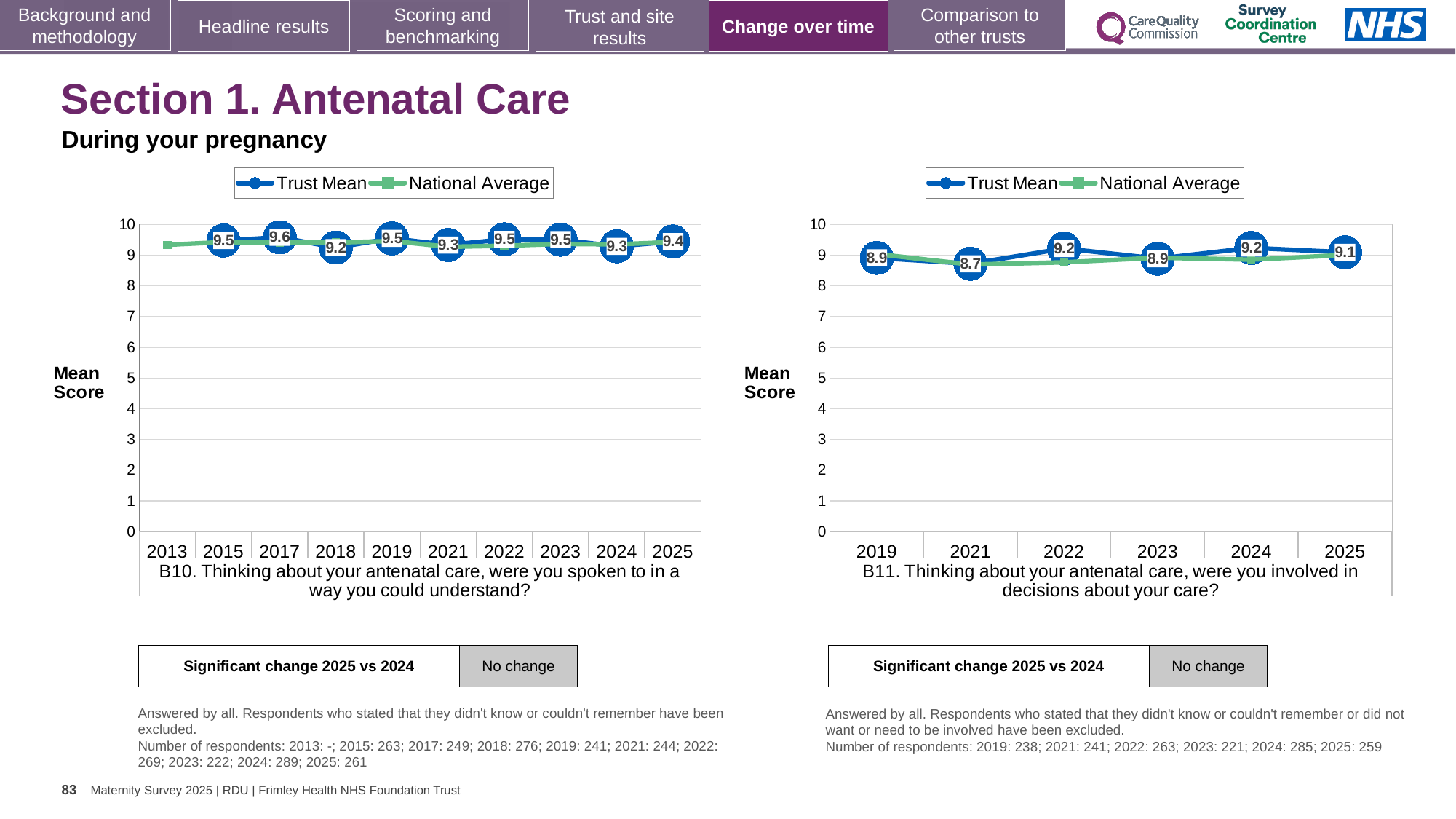
In the B11 chart on the right, which year has the lowest Trust Mean? 2021 In the B11 chart on the right, what is the Trust Mean for 2021? 8.7 How many years are shown on the x axis of the B11 chart on the right? 6 In the B10 chart on the left, what is the Trust Mean for 2017? 9.6 In the B10 chart on the left, what is the difference between the Trust Mean for 2017 and for 2018? 0.4 What kind of chart is the B10 chart on the left? line chart In the B10 chart on the left, which year has the highest Trust Mean? 2017 In the B10 chart on the left, which year has the lowest Trust Mean? 2018 In the B11 chart on the right, what is the difference between the Trust Mean for 2024 and for 2021? 0.5 In the B10 chart on the left, what is the Trust Mean for 2025? 9.4 In the B11 chart on the right, is the Trust Mean for 2022 larger or smaller than the Trust Mean for 2023? larger How many series does the legend of the B10 chart on the left list? 2